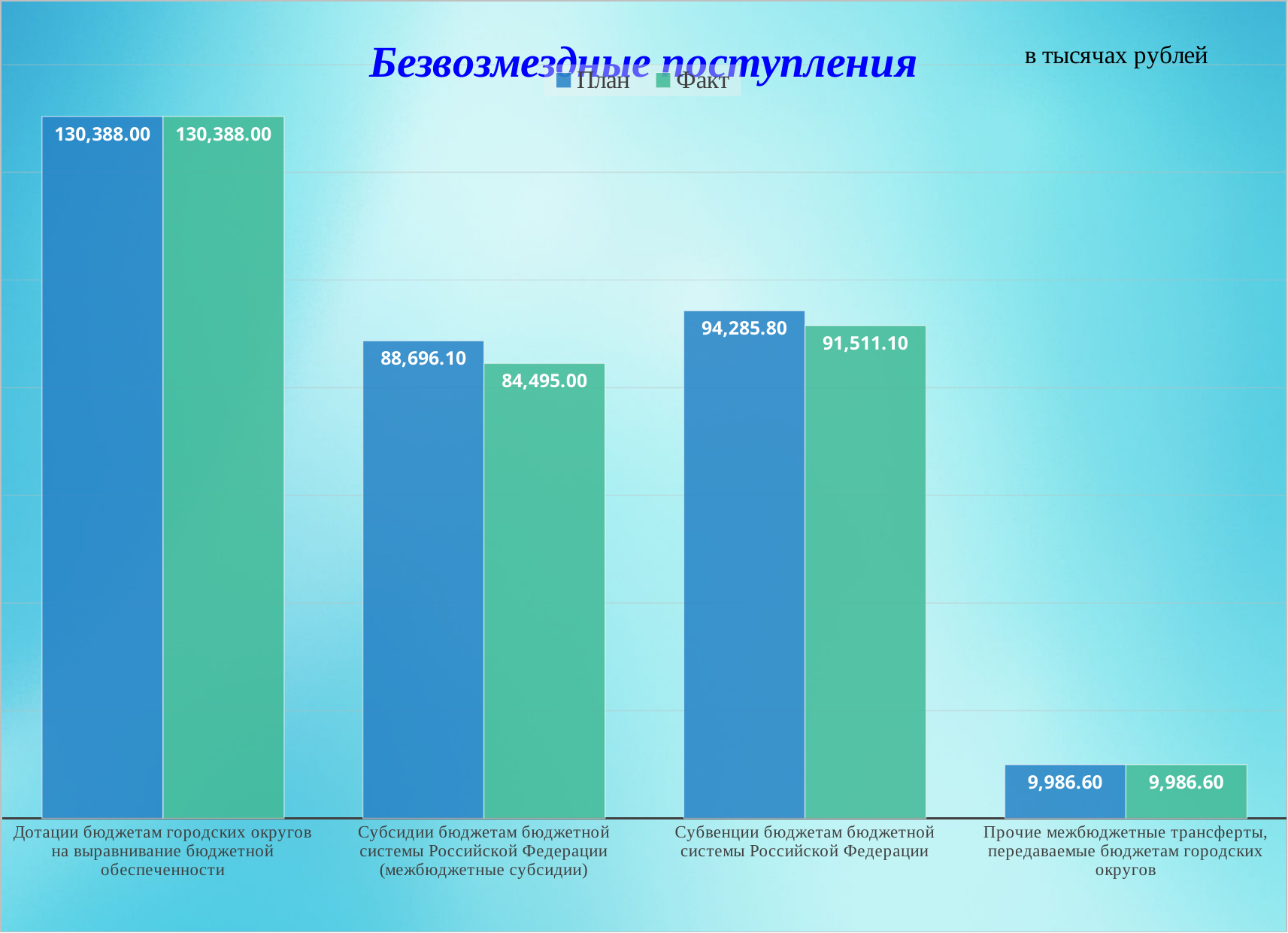
Which category has the highest Факт value? Дотации бюджетам городских округов на выравнивание бюджетной обеспеченности What is the План value for Субсидии бюджетам бюджетной системы Российской Федерации (межбюджетные субсидии)? 88,696.10 What is the difference between the План and Факт values for Субсидии бюджетам бюджетной системы Российской Федерации (межбюджетные субсидии)? 4,201.10 What type of chart is shown on the slide? Bar chart What is the Факт value for Субвенции бюджетам бюджетной системы Российской Федерации? 91,511.10 What is the План value for Прочие межбюджетные трансферты, передаваемые бюджетам городских округов? 9,986.60 Which is larger for Субвенции бюджетам бюджетной системы Российской Федерации: the План value or the Факт value? План How many series does the legend list? 2 Which category has the lowest План value? Прочие межбюджетные трансферты, передаваемые бюджетам городских округов What is the Факт value for Дотации бюджетам городских округов на выравнивание бюджетной обеспеченности? 130,388.00 What is the difference between the План and Факт values for Субвенции бюджетам бюджетной системы Российской Федерации? 2,774.70 How many categories are shown on the x axis? 4